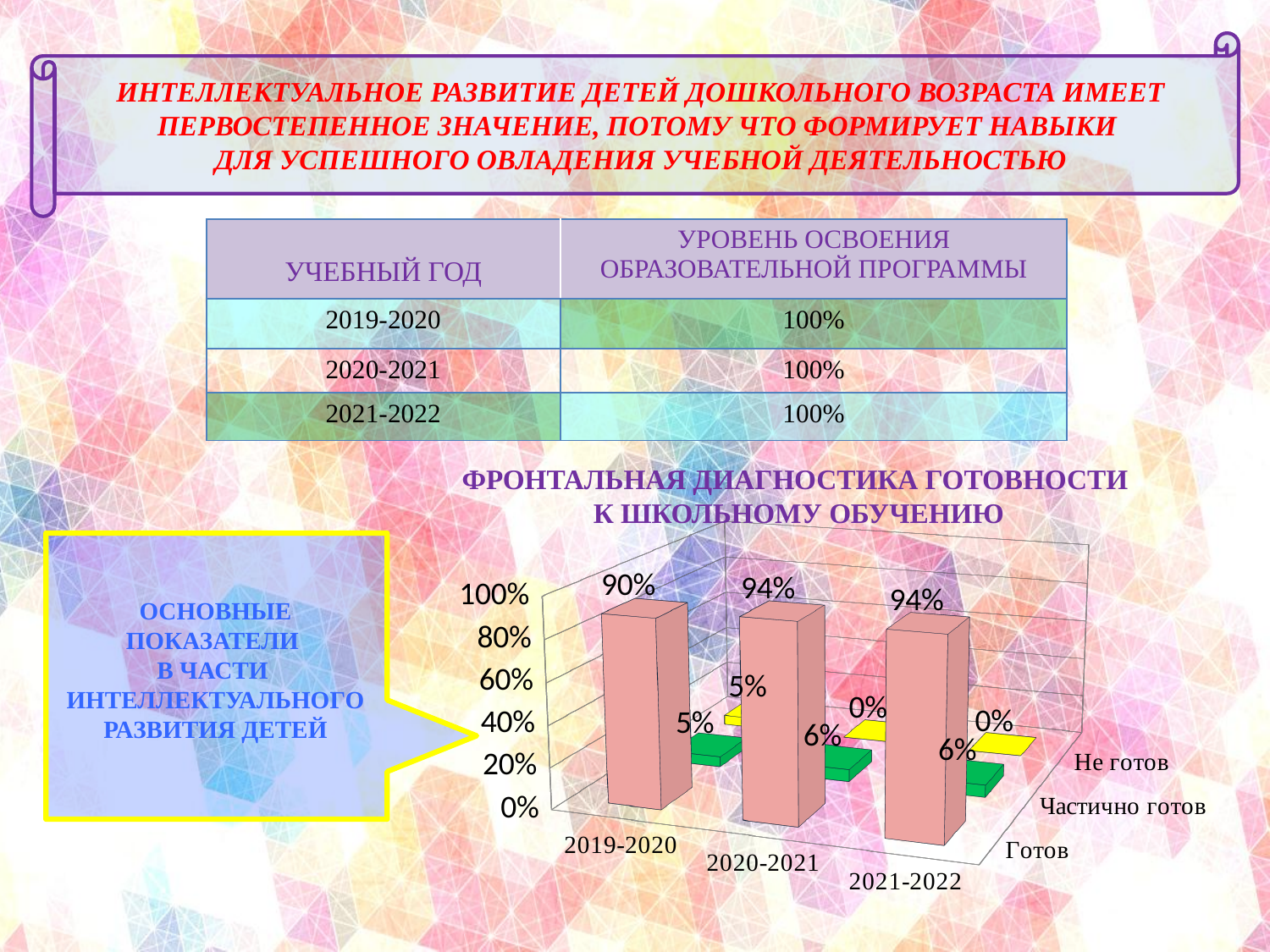
Which is larger on the chart: "Частично готов" in 2019-2020 or "Частично готов" in 2021-2022? 2021-2022 What is the value for "Не готов" in 2019-2020 on the chart? 5% What is the difference between the "Готов" values for 2020-2021 and 2019-2020? 4% Is the "Готов" value for 2020-2021 greater or less than 80%? greater In which school year is the "Готов" value lowest on the chart? 2019-2020 What is the value for "Частично готов" in 2020-2021 on the chart? 6% What is the value for "Готов" in 2021-2022 on the chart? 94% What is the value for "Готов" in 2019-2020 on the chart "Фронтальная диагностика готовности к школьному обучению"? 90% What is the value for "Не готов" in 2021-2022 on the chart? 0% How many readiness categories (data series) does the chart plot? 3 How many school years are shown on the x axis of the chart? 3 What type of chart is used for "Фронтальная диагностика готовности к школьному обучению"? bar chart